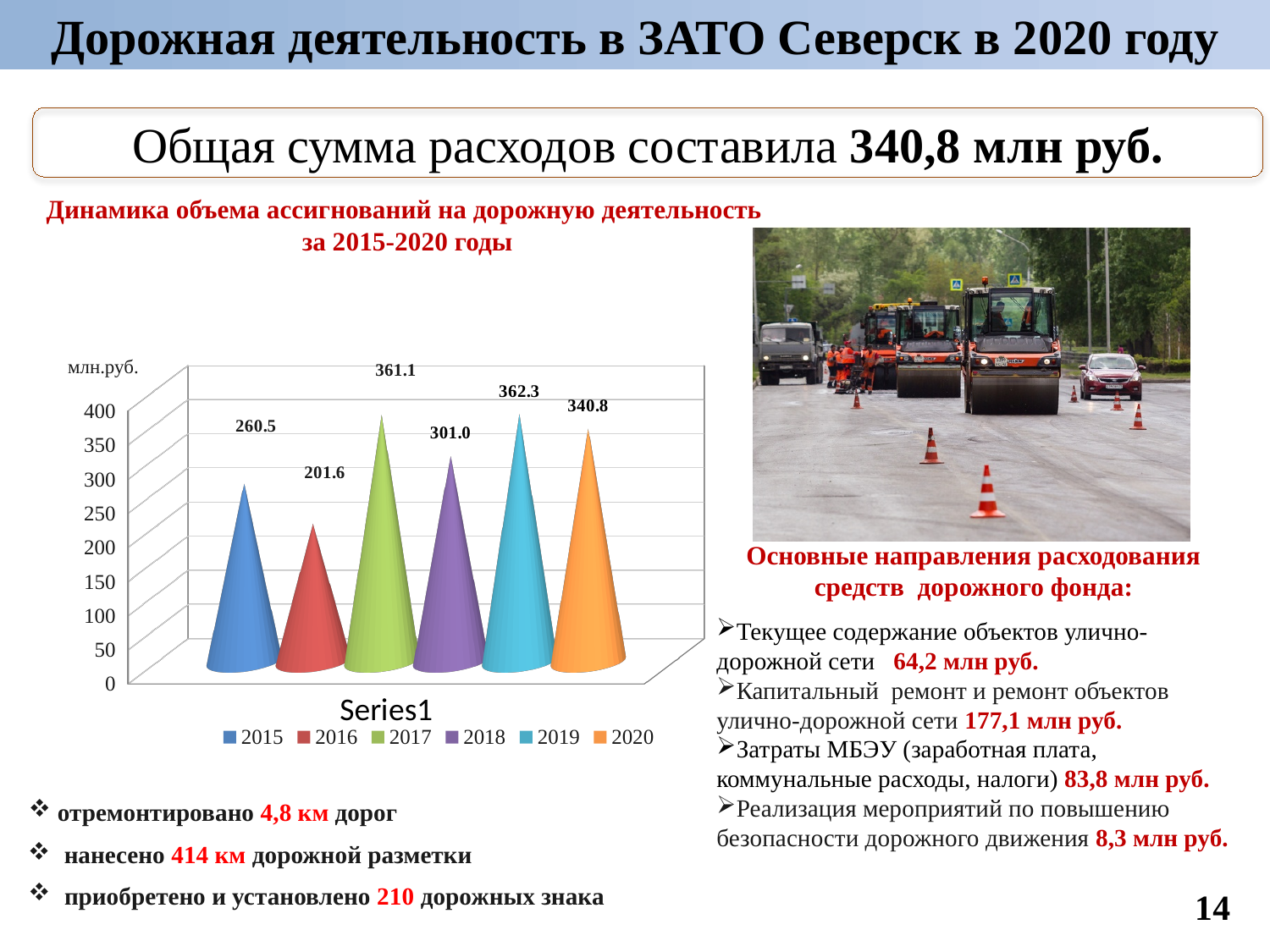
What is the difference between the values for 2017 and 2016? 159.5 What is the value for 2020 in the chart? 340.8 Is the value for 2016 greater or less than 250? less What is the difference between the values for 2020 and 2015? 80.3 How many cones (data points) are plotted in the chart? 6 How many entries does the chart legend list? 6 Which is larger, the value for 2018 or the value for 2015? 2018 What is the value for 2017 in the chart? 361.1 Which year has the lowest value in the chart? 2016 Which year has the highest value in the chart? 2019 What is the value for 2015 in the chart? 260.5 What unit is shown on the vertical axis of the chart? млн.руб.